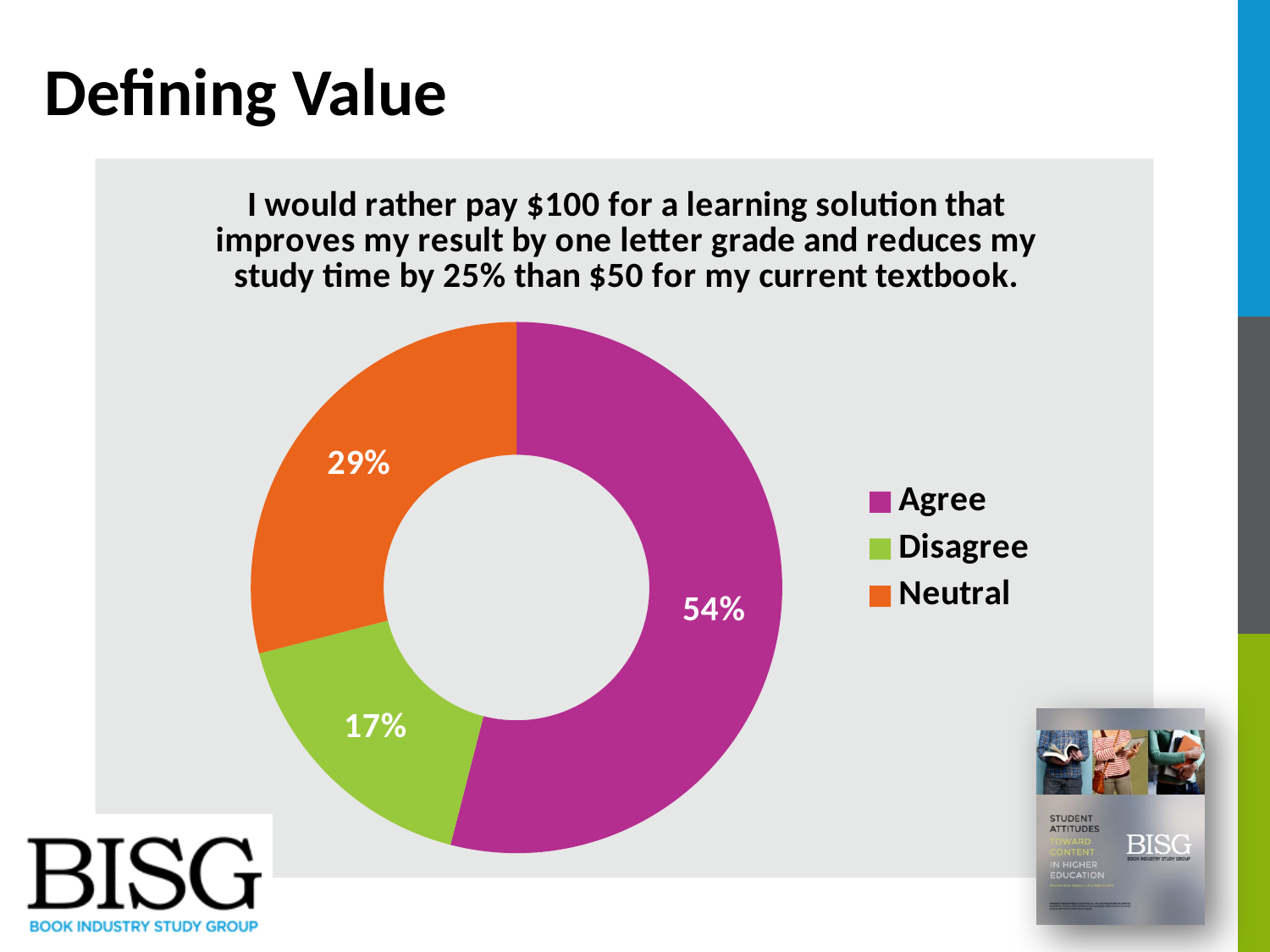
How many categories does the chart show? 3 Which is larger, the share for Neutral or the share for Disagree? Neutral What colour represents the Agree category in the chart? Magenta What is the difference in percentage points between Neutral and Disagree? 12 Which response category has the smallest share? Disagree What percentage of respondents Disagree with the statement? 17% What is the difference in percentage points between Agree and Neutral? 25 What is the title of the slide? Defining Value Which response category has the largest share? Agree What kind of chart is shown on the slide? Doughnut (pie) chart What percentage of respondents are Neutral on the statement? 29% What percentage of respondents Agree with the statement? 54%